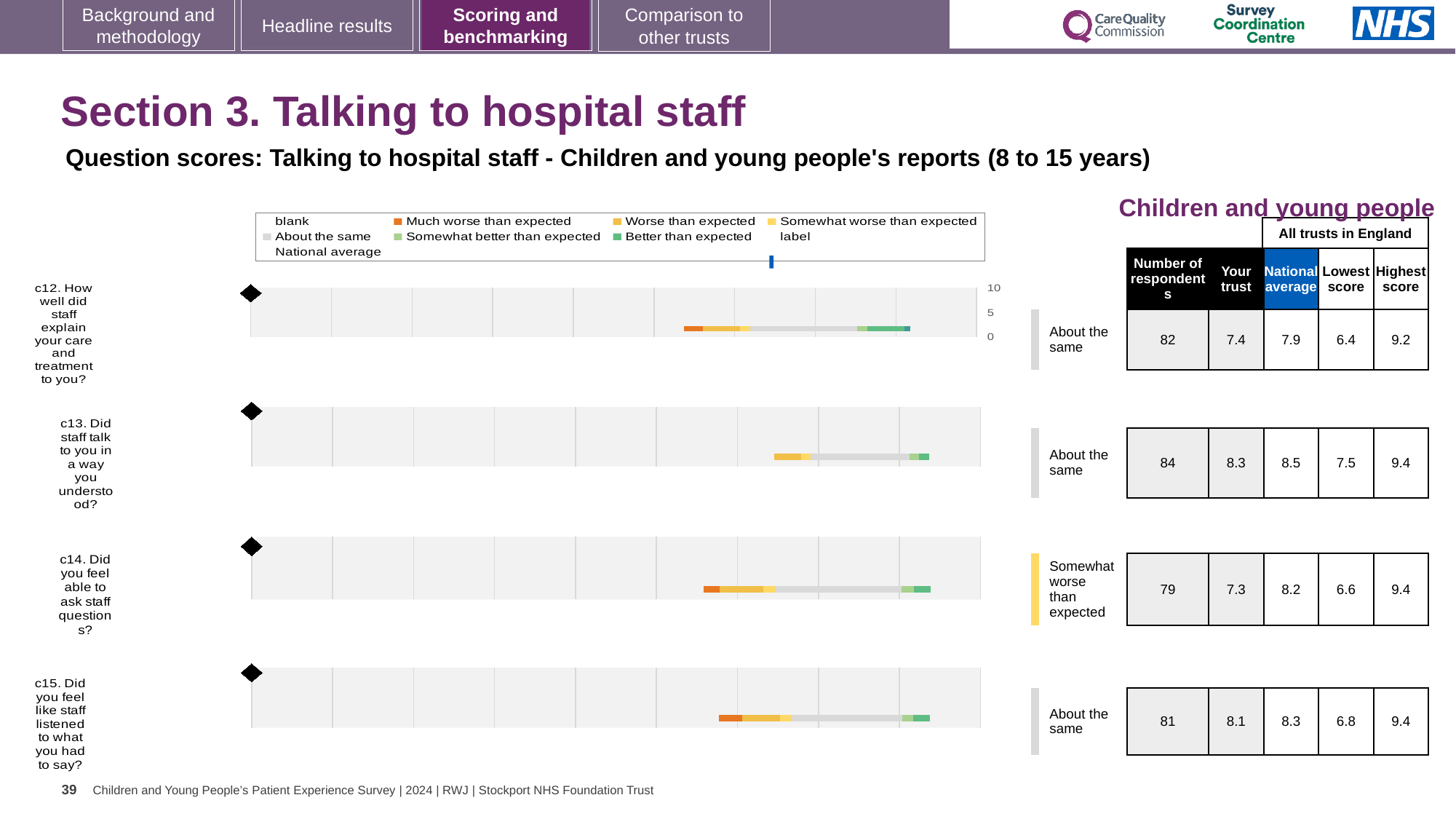
Which question has the lowest 'Your trust' score? c14 Which benchmark category is shown for question c14 (Did you feel able to ask staff questions?)? Somewhat worse than expected For question c14, what is the difference between the national average (8.2) and the 'Your trust' score (7.3)? 0.9 What colour does the legend use for 'Much worse than expected'? Orange What is the 'Your trust' score for question c12 (How well did staff explain your care and treatment to you?)? 7.4 What is the national average score for question c13 (Did staff talk to you in a way you understood?)? 8.5 How many respondents answered question c15 (Did you feel like staff listened to what you had to say?)? 81 What kind of chart is used to show the benchmark bands for questions c12 to c15? Bar chart How many survey questions (c12 to c15) have a chart on this slide? 4 For question c12, which is larger: the 'Your trust' score or the national average? National average How many of the four questions are rated 'About the same'? 3 Which question has the highest 'Your trust' score? c13